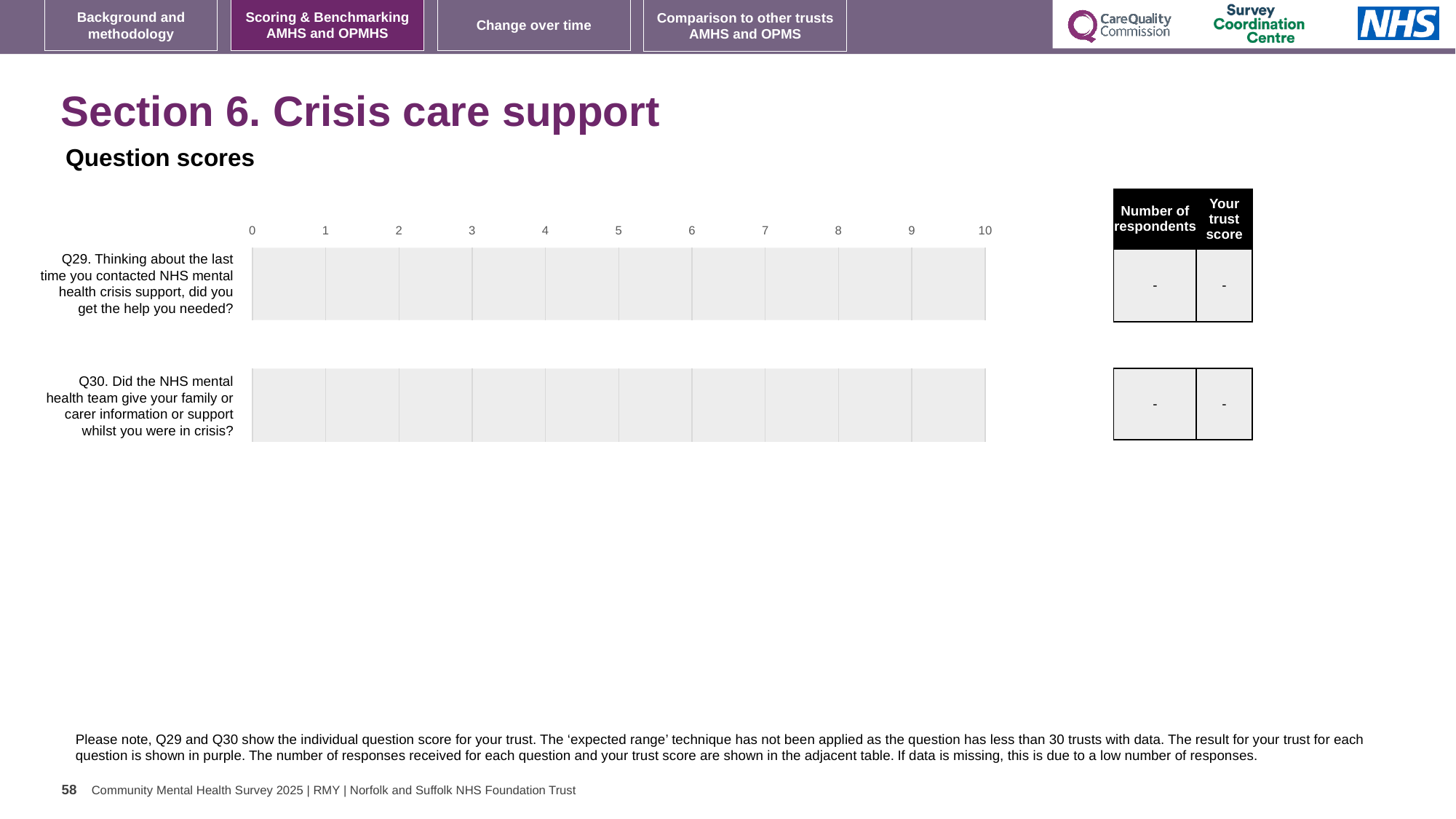
Is a bar plotted for Q30 on the chart? No What is shown in the 'Number of respondents' column for Q30? - Which question number is listed first (at the top) on the chart? Q29 What is shown in the 'Your trust score' column for Q29? - What kind of chart is shown on the slide? bar chart What is the highest value shown on the chart's axis? 10 What is the lowest value shown on the chart's axis? 0 How many questions (categories) are listed on the chart? 2